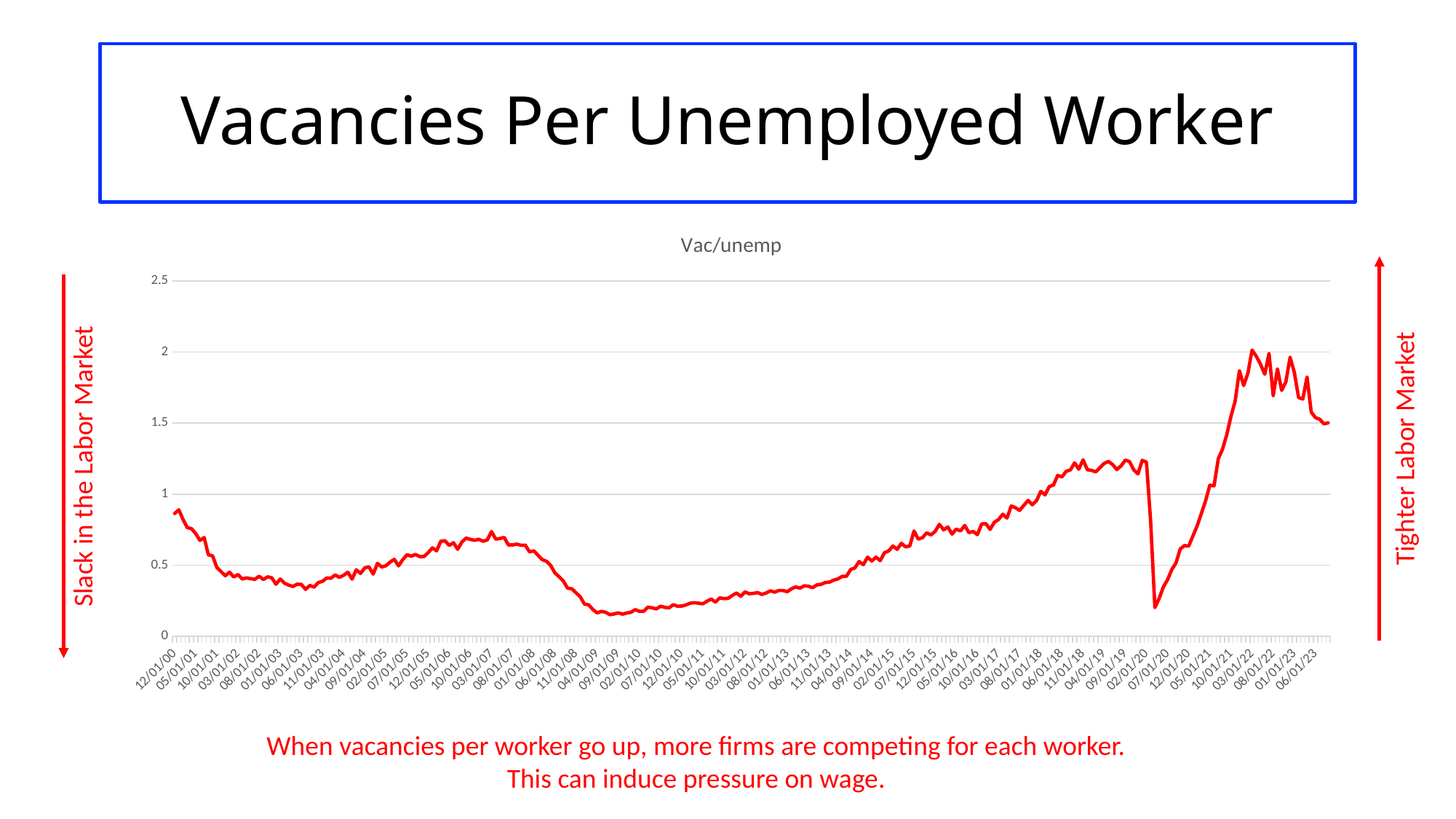
Is the value at 11/01/18 greater or less than 1? greater How many data series are plotted in the chart? 1 What is the title printed above the chart? Vac/unemp Does the line rise or fall between 12/01/00 and 03/01/02? fall What is the highest value shown on the vertical axis? 2.5 Does the line rise or fall between 04/01/09 and 11/01/18? rise What kind of chart is shown on the slide? line chart Is the value at 08/01/22 greater or less than 1.5? greater Is the value at 12/01/00 greater or less than 1? less